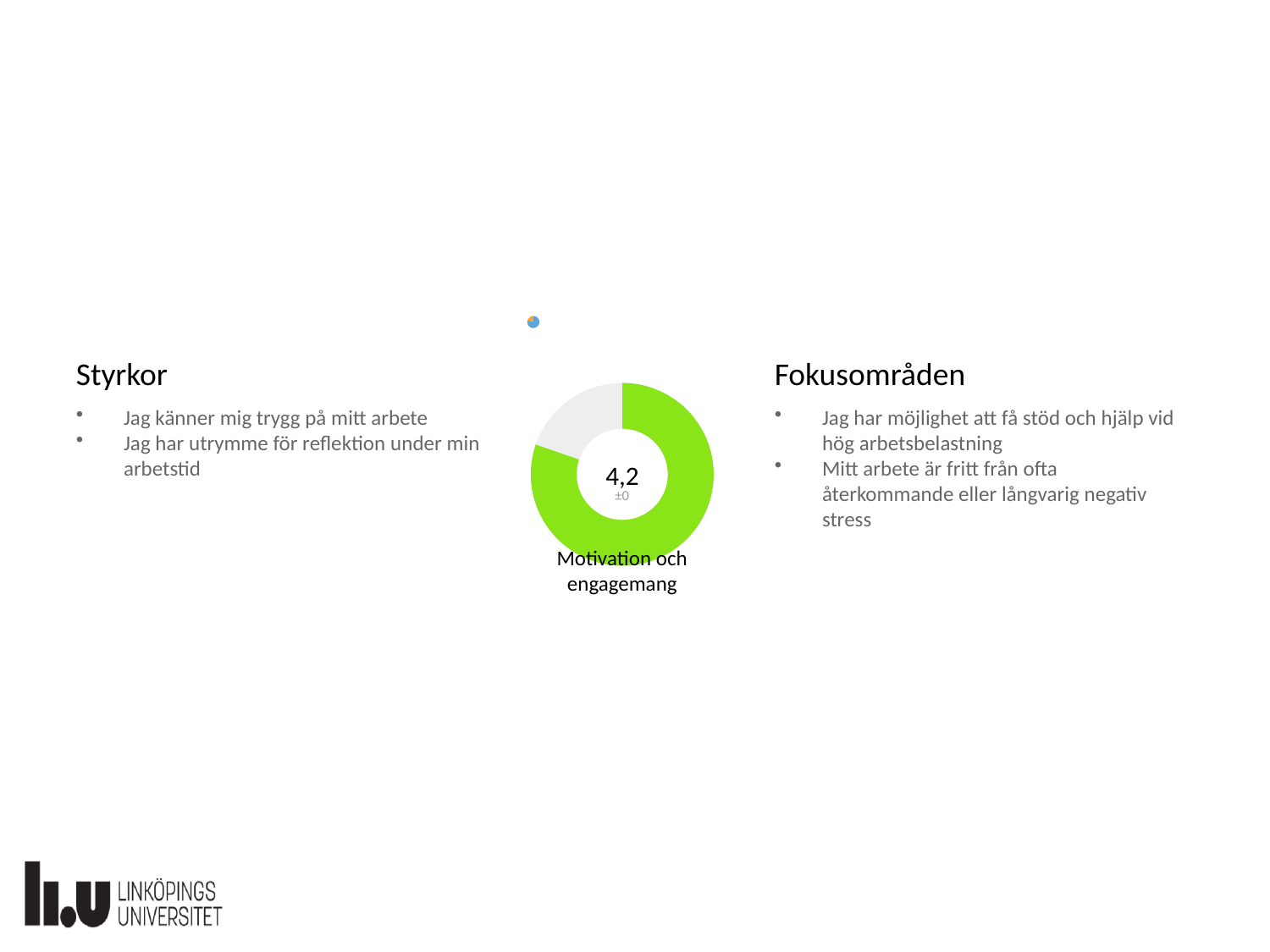
What label appears below the donut chart? Motivation och engagemang What colour is the largest segment of the donut chart? Green What kind of chart is shown in the centre of the slide? Donut chart What value is printed in the centre of the donut chart? 4,2 How many segments does the donut chart have? 2 What small value is printed directly under the 4,2 in the centre of the donut chart? ±0 Which segment of the donut chart is larger, the green one or the grey one? The green one